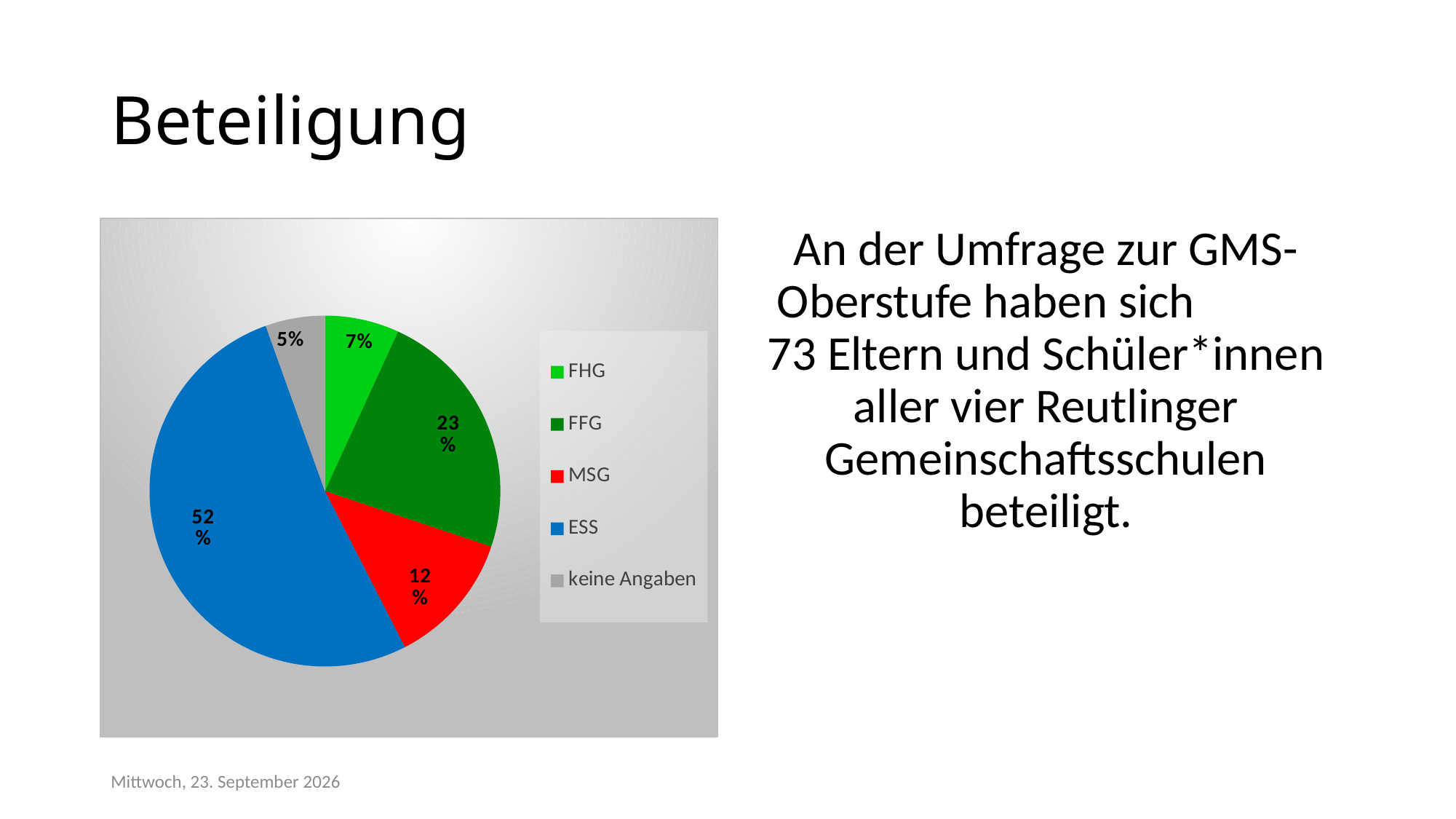
Which category has the largest slice of the pie? ESS What colour is the ESS slice? blue What share of the pie does MSG have? 12% What share of the pie does ESS have? 52% How many categories does the legend list? 5 What share of the pie does FFG have? 23% What kind of chart is shown on the slide? pie chart Which is larger, the share for MSG or the share for FHG? MSG What is the difference in percentage points between ESS and FFG? 29 Which category has the smallest slice of the pie? keine Angaben What share of the pie does 'keine Angaben' have? 5% What share of the pie does FHG have? 7%